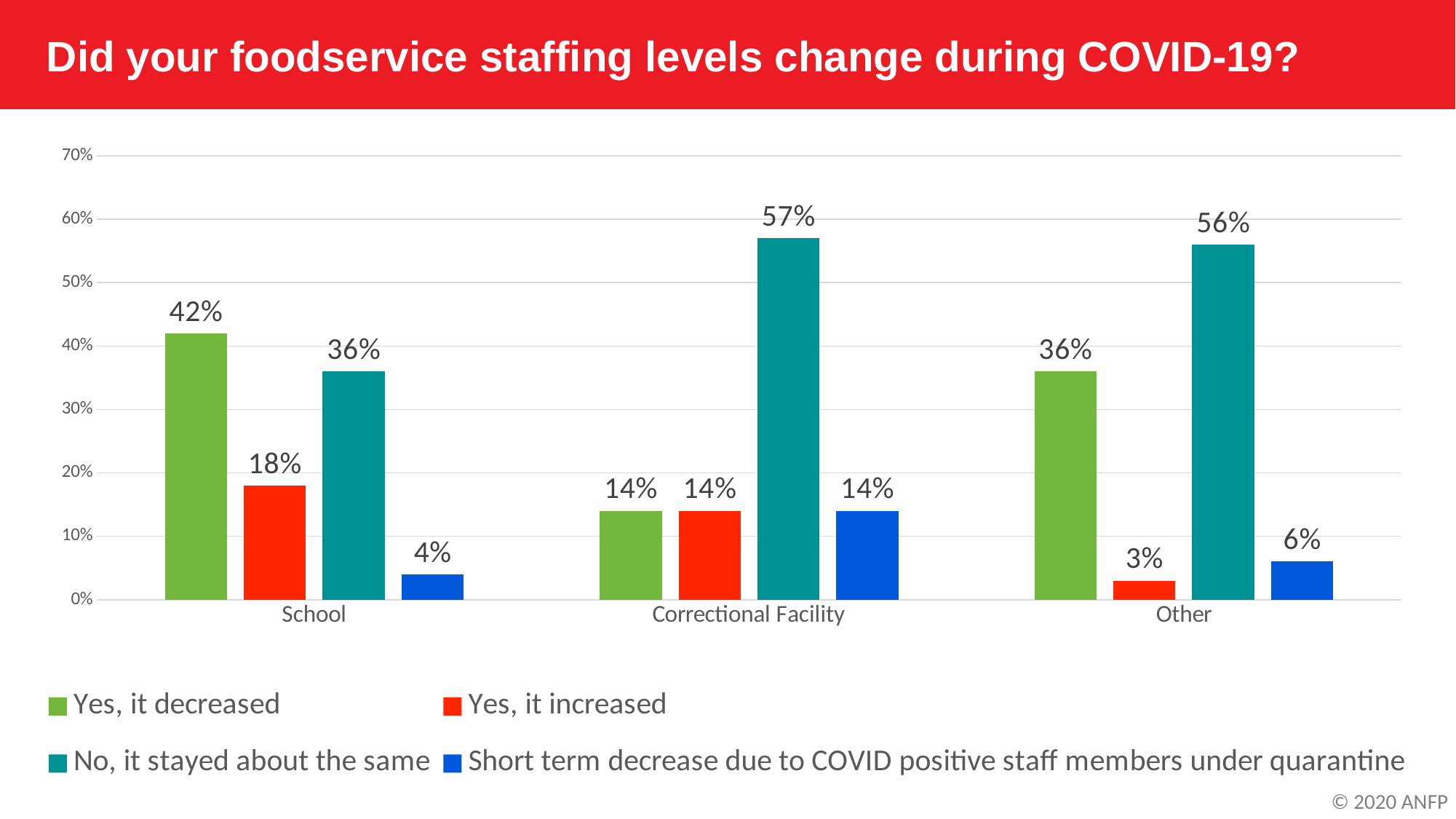
What percentage of School respondents said staffing levels decreased? 42% How many series does the legend list? 4 What percentage of Other respondents said 'Yes, it increased'? 3% Which category has the lowest value for 'Yes, it increased'? Other What is the value for 'Short term decrease due to COVID positive staff members under quarantine' for School? 4% What colour represents 'Yes, it increased' in the legend? Red What is the value for 'No, it stayed about the same' for Correctional Facility? 57% What kind of chart is shown on the slide? Bar chart How many categories are shown on the x axis? 3 Which is larger for School: 'Yes, it decreased' or 'No, it stayed about the same'? Yes, it decreased Which category has the highest value for 'No, it stayed about the same'? Correctional Facility What is the difference between the 'Yes, it decreased' values for School and Other? 6%